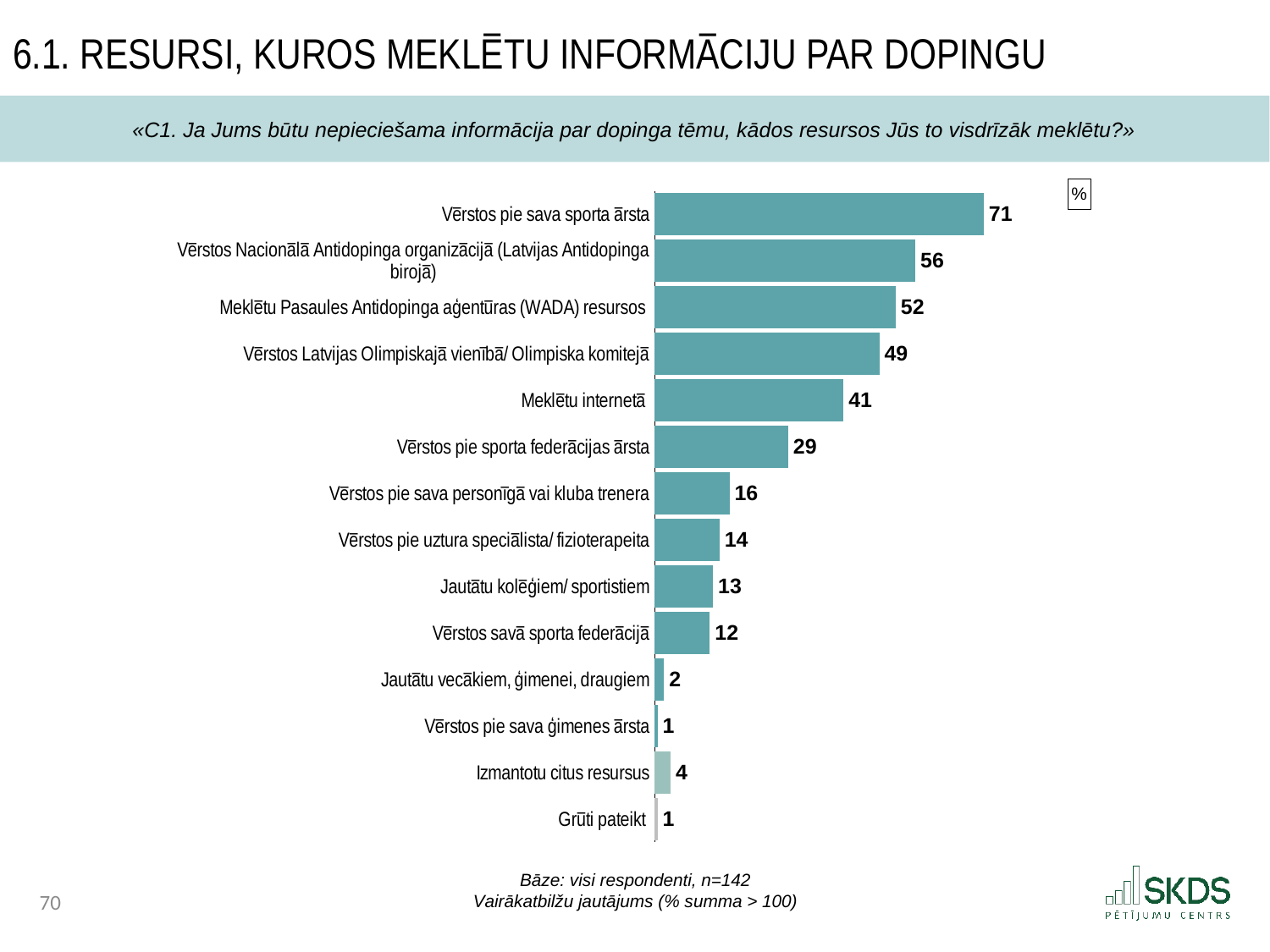
What is the difference between the values for "Vērstos pie sava sporta ārsta" and "Vērstos Nacionālā Antidopinga organizācijā (Latvijas Antidopinga birojā)"? 15 Which category has the highest value? Vērstos pie sava sporta ārsta What is the value for "Vērstos pie sporta federācijas ārsta"? 29 What is the difference between the values for "Meklētu Pasaules Antidopinga aģentūras (WADA) resursos" and "Vērstos Latvijas Olimpiskajā vienībā/ Olimpiska komitejā"? 3 How many categories are shown in the chart? 14 What is the value for "Izmantotu citus resursus"? 4 What is the base (n) of respondents stated below the chart? n=142 What is the value for "Vērstos pie sava sporta ārsta"? 71 What is the value for "Meklētu internetā"? 41 What type of chart is shown on the slide? bar chart What is the value for "Jautātu vecākiem, ģimenei, draugiem"? 2 Which is larger: the value for "Vērstos pie sava personīgā vai kluba trenera" or the value for "Jautātu kolēģiem/ sportistiem"? Vērstos pie sava personīgā vai kluba trenera